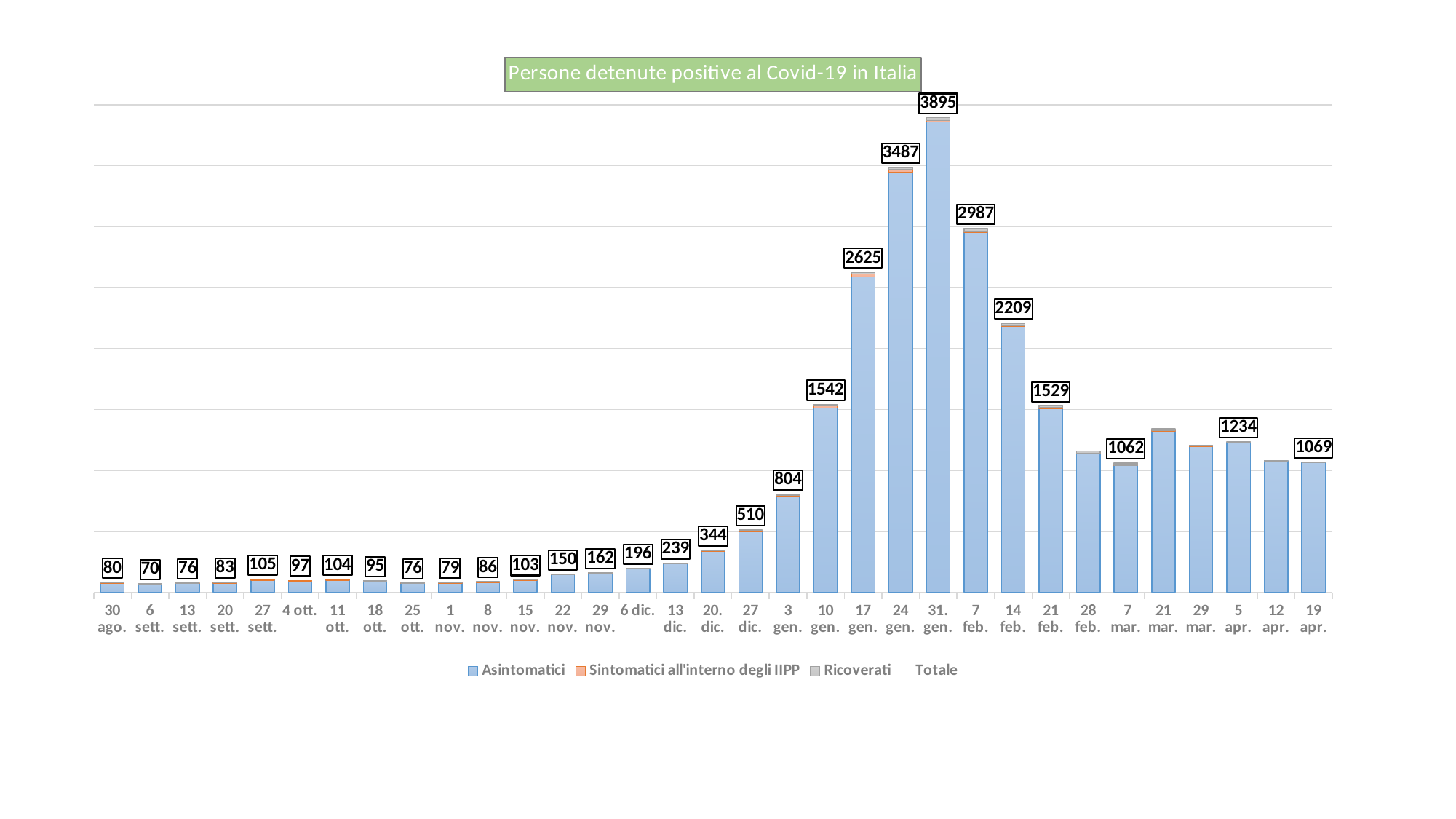
Which is larger, the total for 7 feb. or the total for 14 feb.? 7 feb. What is the difference between the totals for 24 gen. and 17 gen.? 862 What is the total value shown for 31. gen.? 3895 How many dates are shown on the x axis? 33 Which date has the lowest total? 6 sett. What is the total value shown for 3 gen.? 804 What kind of chart is this? Stacked bar chart Which date has the highest total? 31. gen. What is the total value shown for 19 apr.? 1069 What is the title of the chart? Persone detenute positive al Covid-19 in Italia Do the totals rise or fall from 6 dic. to 31. gen.? Rise How many series does the legend list? 4